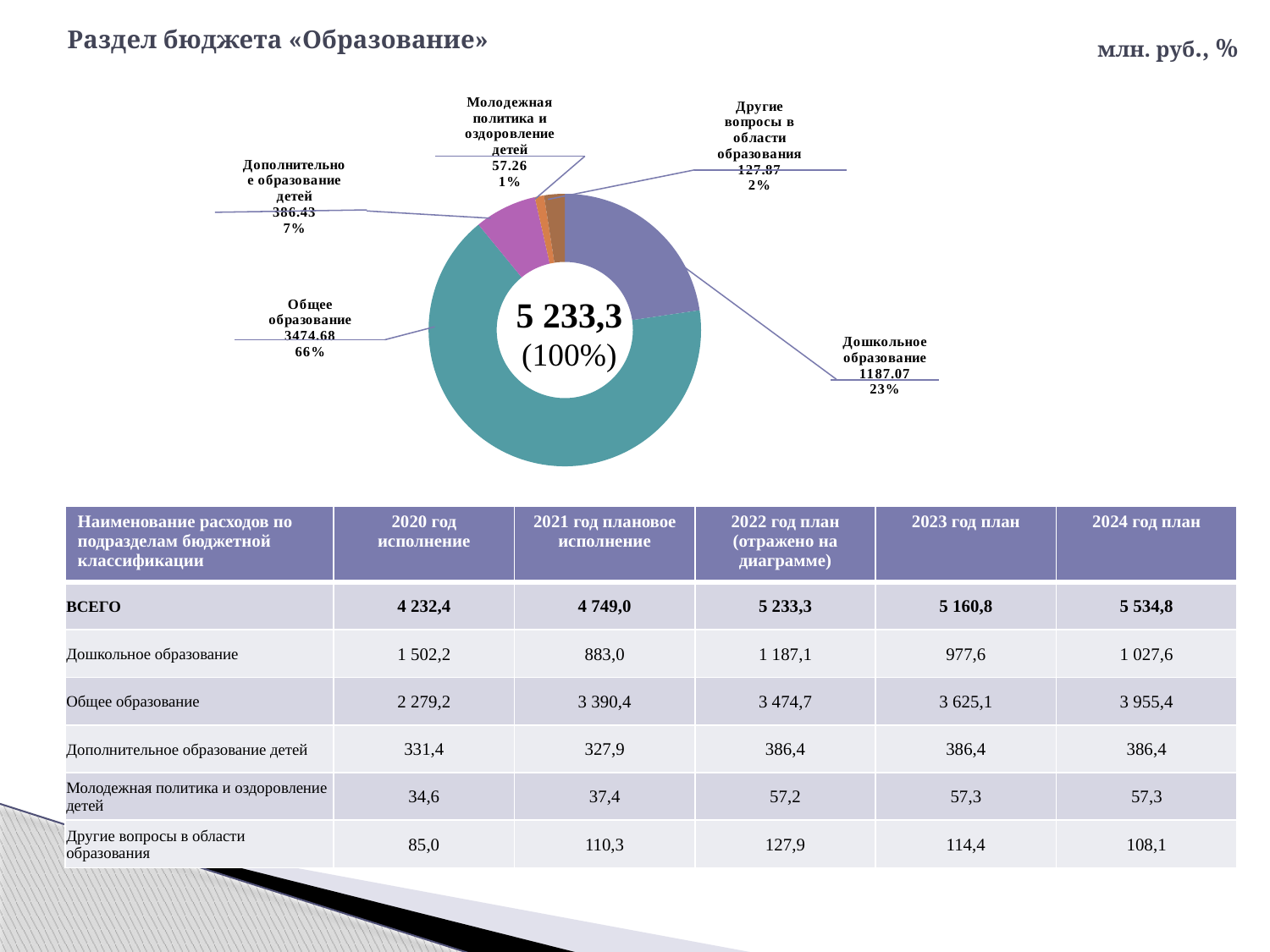
What value is shown for Другие вопросы в области образования on the chart? 127.87 How many categories are shown on the chart? 5 What type of chart is shown on the slide? doughnut chart Which category has the smallest share of the chart? Молодежная политика и оздоровление детей Which category has the largest share of the chart? Общее образование What is the difference between the percentage shares of Общее образование and Дошкольное образование on the chart? 43% What value is shown for Дополнительное образование детей on the chart? 386.43 What percentage share does Дошкольное образование have on the chart? 23% What value is shown for Общее образование on the chart? 3474.68 What percentage share does Молодежная политика и оздоровление детей have on the chart? 1% What total value is shown in the centre of the chart? 5 233,3 Which is larger on the chart: Дошкольное образование or Дополнительное образование детей? Дошкольное образование